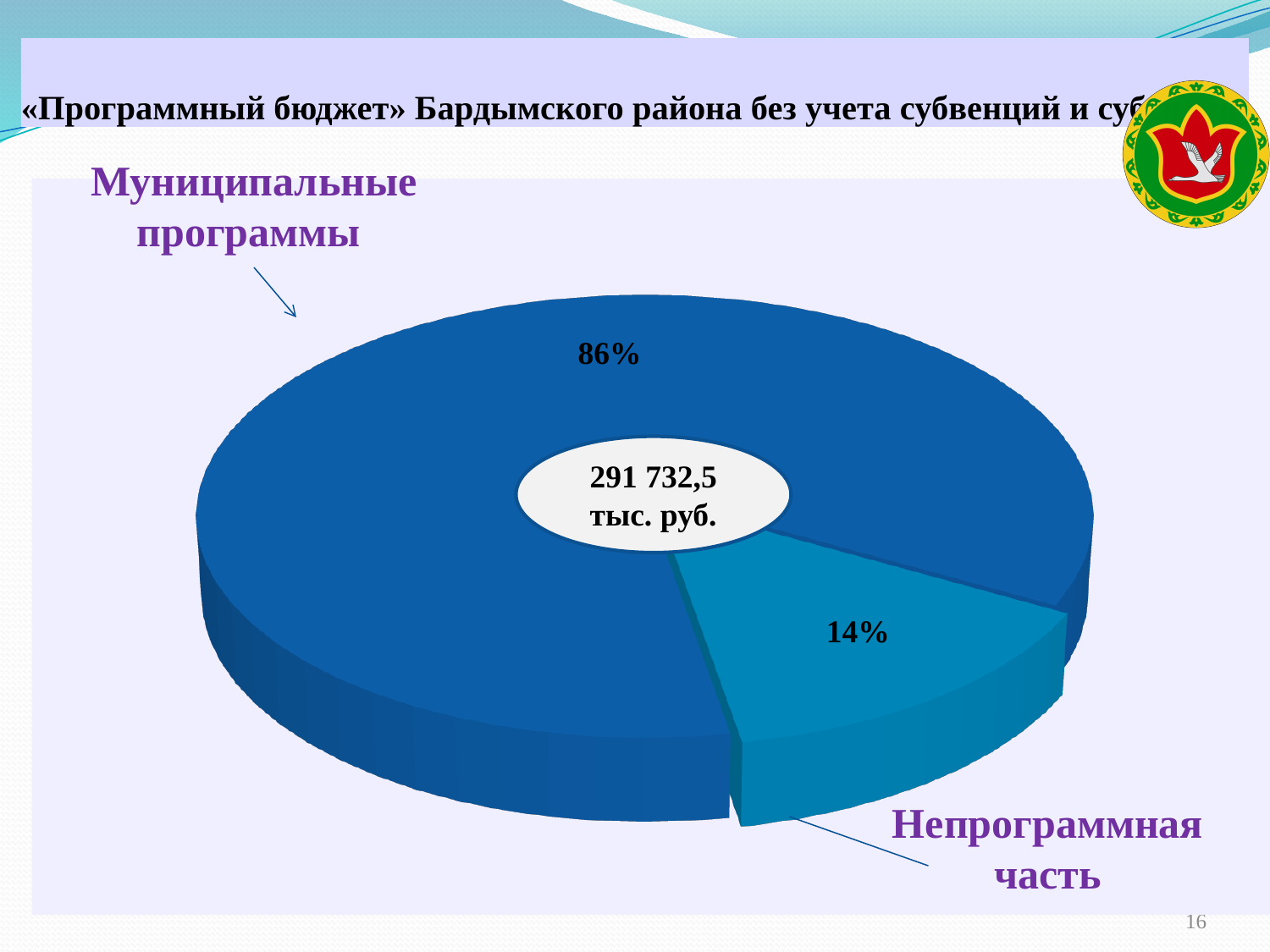
Which is larger: the share for "Муниципальные программы" or for "Непрограммная часть"? Муниципальные программы How many slices does the pie chart have? 2 What colour is the "Непрограммная часть" slice? light blue (teal) What share of the pie does "Непрограммная часть" take? 14% What kind of chart is shown on the slide? pie chart What is the difference in percentage points between "Муниципальные программы" and "Непрограммная часть"? 72 Which slice of the pie is the largest? Муниципальные программы Which slice of the pie is the smallest? Непрограммная часть What total amount is printed in the centre of the pie chart? 291 732,5 тыс. руб. What share of the pie does "Муниципальные программы" take? 86%